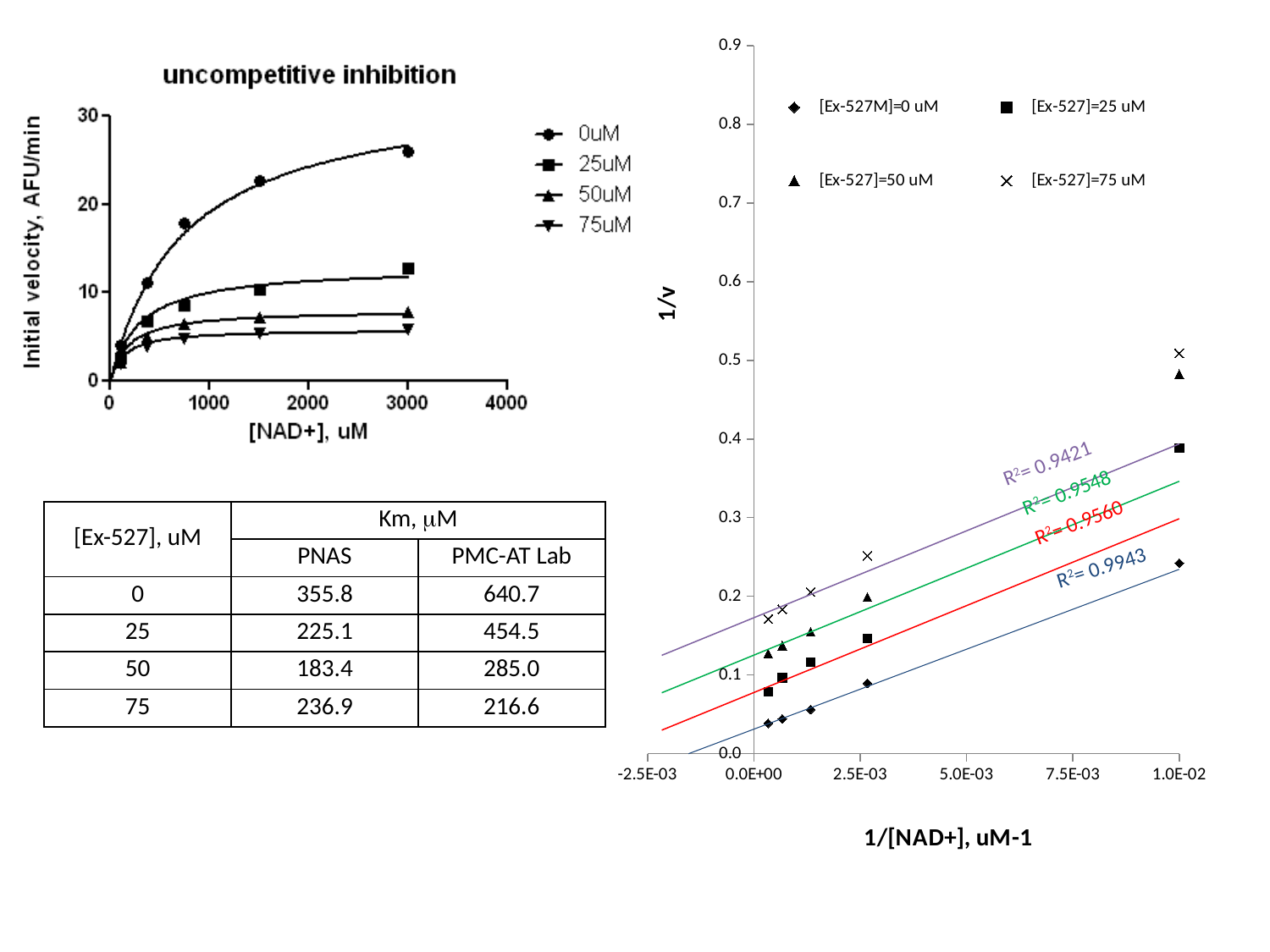
In the left chart titled 'uncompetitive inhibition', which series has the highest initial velocity at [NAD+] = 3000 uM? 0uM What is the title of the chart on the left of the slide? uncompetitive inhibition In the left chart titled 'uncompetitive inhibition', is the initial velocity for the 0uM series at [NAD+] = 3000 uM greater or less than 20? greater In the right chart (1/v versus 1/[NAD+]), how many series does the legend list? 4 In the left chart titled 'uncompetitive inhibition', what is the label of the y axis? Initial velocity, AFU/min In the right chart (1/v versus 1/[NAD+]), is the 1/v value for the [Ex-527M]=0 uM series at 1/[NAD+] = 1.0E-02 greater or less than 0.3? less In the left chart titled 'uncompetitive inhibition', how many series does the legend list? 4 In the left chart titled 'uncompetitive inhibition', is the initial velocity for the 75uM series at [NAD+] = 3000 uM greater or less than 10? less In the right chart (1/v versus 1/[NAD+]), what is the highest R² value shown? 0.9943 In the right chart (1/v versus 1/[NAD+]), what is the lowest R² value shown? 0.9421 In the left chart titled 'uncompetitive inhibition', which series has the lowest initial velocity at [NAD+] = 3000 uM? 75uM In the left chart titled 'uncompetitive inhibition', does the initial velocity for the 0uM series rise or fall as [NAD+] increases? rise